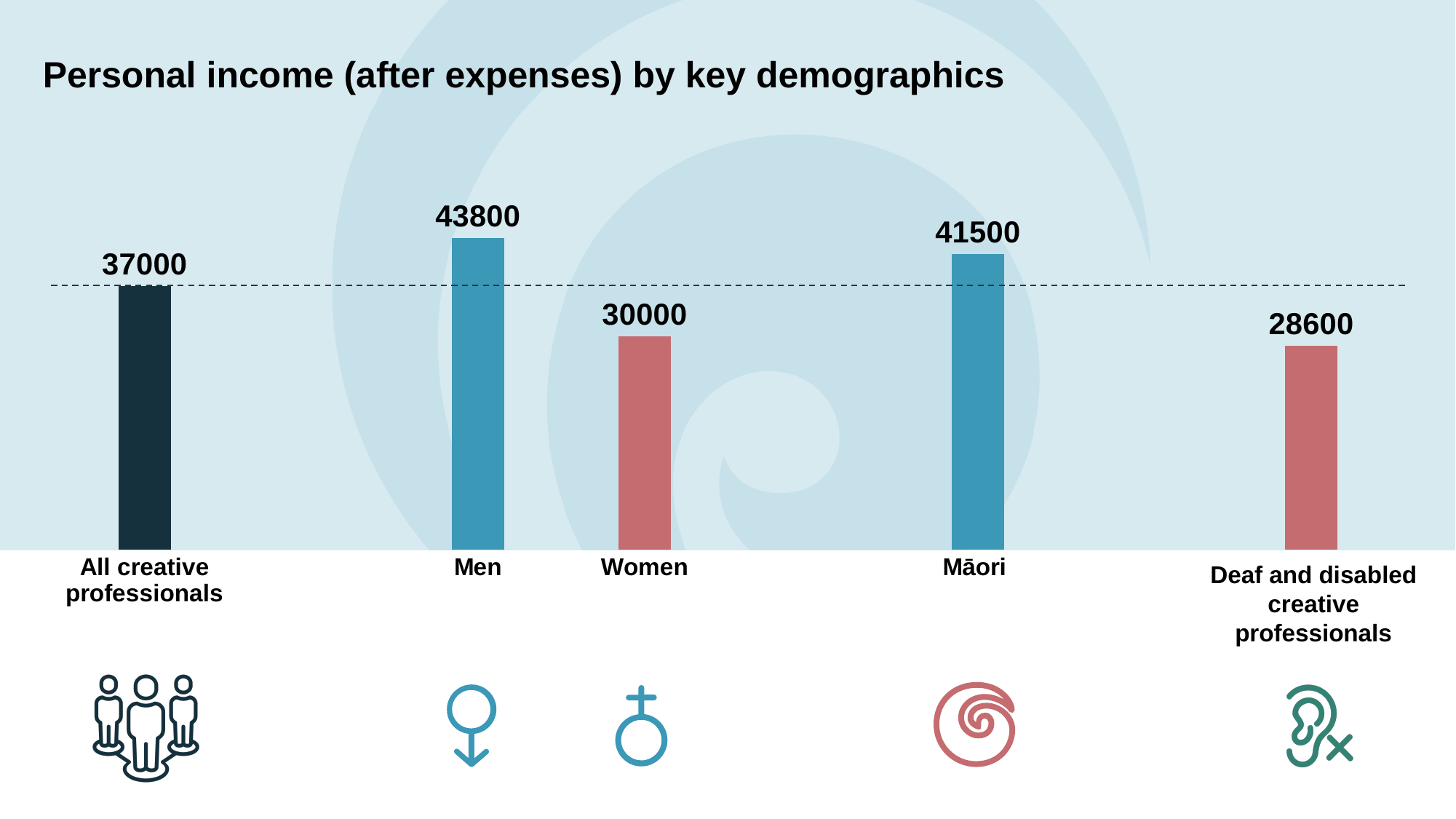
What is the difference in personal income between All creative professionals and Deaf and disabled creative professionals? 8400 Which has a higher personal income, Māori or Women? Māori What is the difference in personal income between Men and Women? 13800 What is the personal income (after expenses) for Māori? 41500 What is the personal income (after expenses) for Women? 30000 What is the personal income (after expenses) for Men? 43800 Which category has the highest personal income? Men What type of chart is shown on the slide? Bar chart What is the personal income (after expenses) for Deaf and disabled creative professionals? 28600 Which category has the lowest personal income? Deaf and disabled creative professionals How many categories are shown in the chart? 5 What is the personal income (after expenses) for All creative professionals? 37000